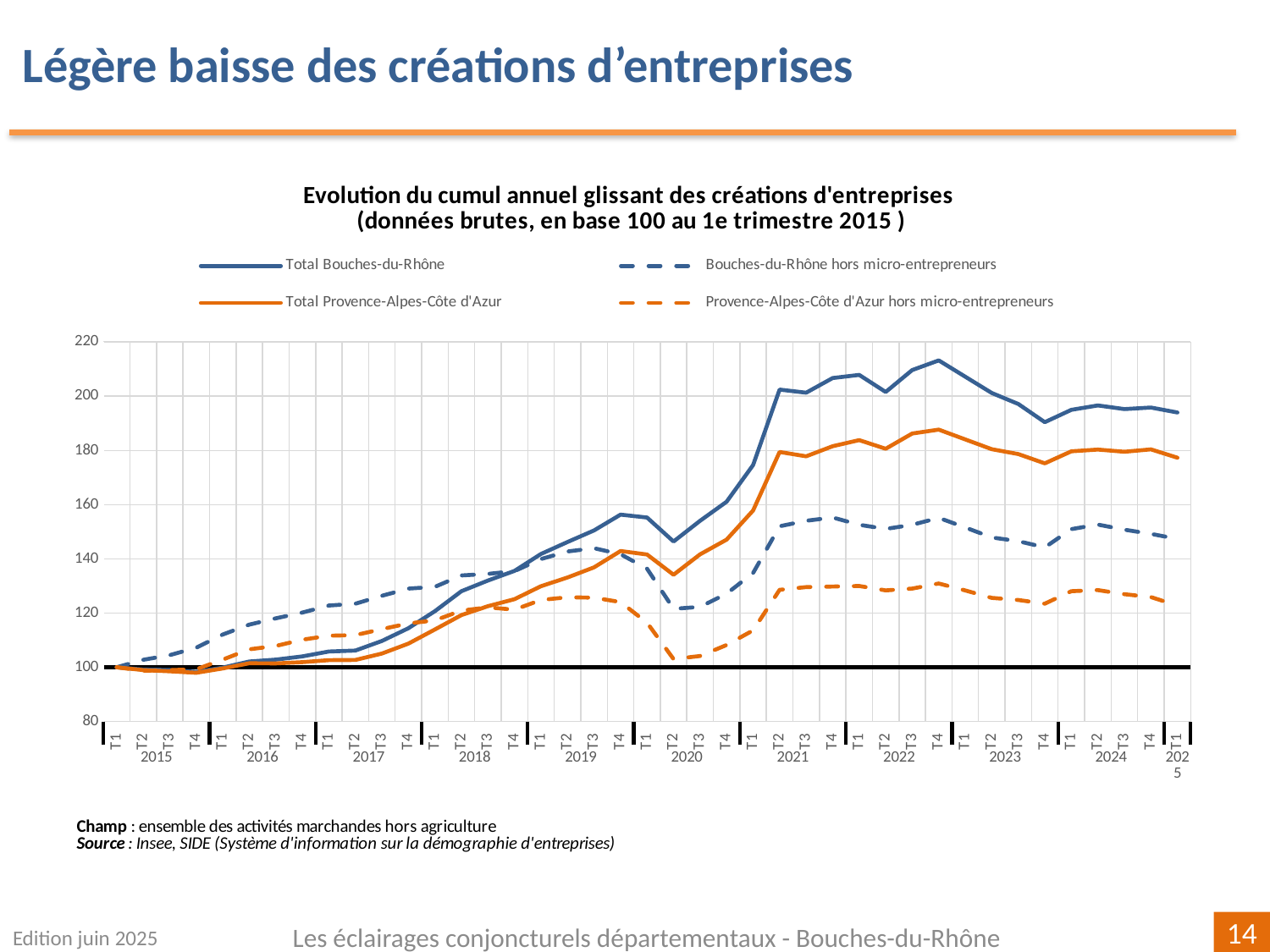
Which series has the lowest value at T2 2020? Provence-Alpes-Côte d'Azur hors micro-entrepreneurs At T1 2025, which is higher: Total Bouches-du-Rhône or Total Provence-Alpes-Côte d'Azur? Total Bouches-du-Rhône Which series is drawn as a solid orange line? Total Provence-Alpes-Côte d'Azur How many series does the chart legend list? 4 What is the title of the chart? Evolution du cumul annuel glissant des créations d'entreprises (données brutes, en base 100 au 1e trimestre 2015 ) Is the value for Bouches-du-Rhône hors micro-entrepreneurs at T1 2025 greater or less than 160? less Is the value for Total Provence-Alpes-Côte d'Azur at T4 2022 greater or less than 180? greater Is the value for Total Bouches-du-Rhône at T1 2025 greater or less than 200? less Does the Total Bouches-du-Rhône series rise or fall between T1 2015 and T4 2022? rise What kind of chart is shown on the slide? line chart